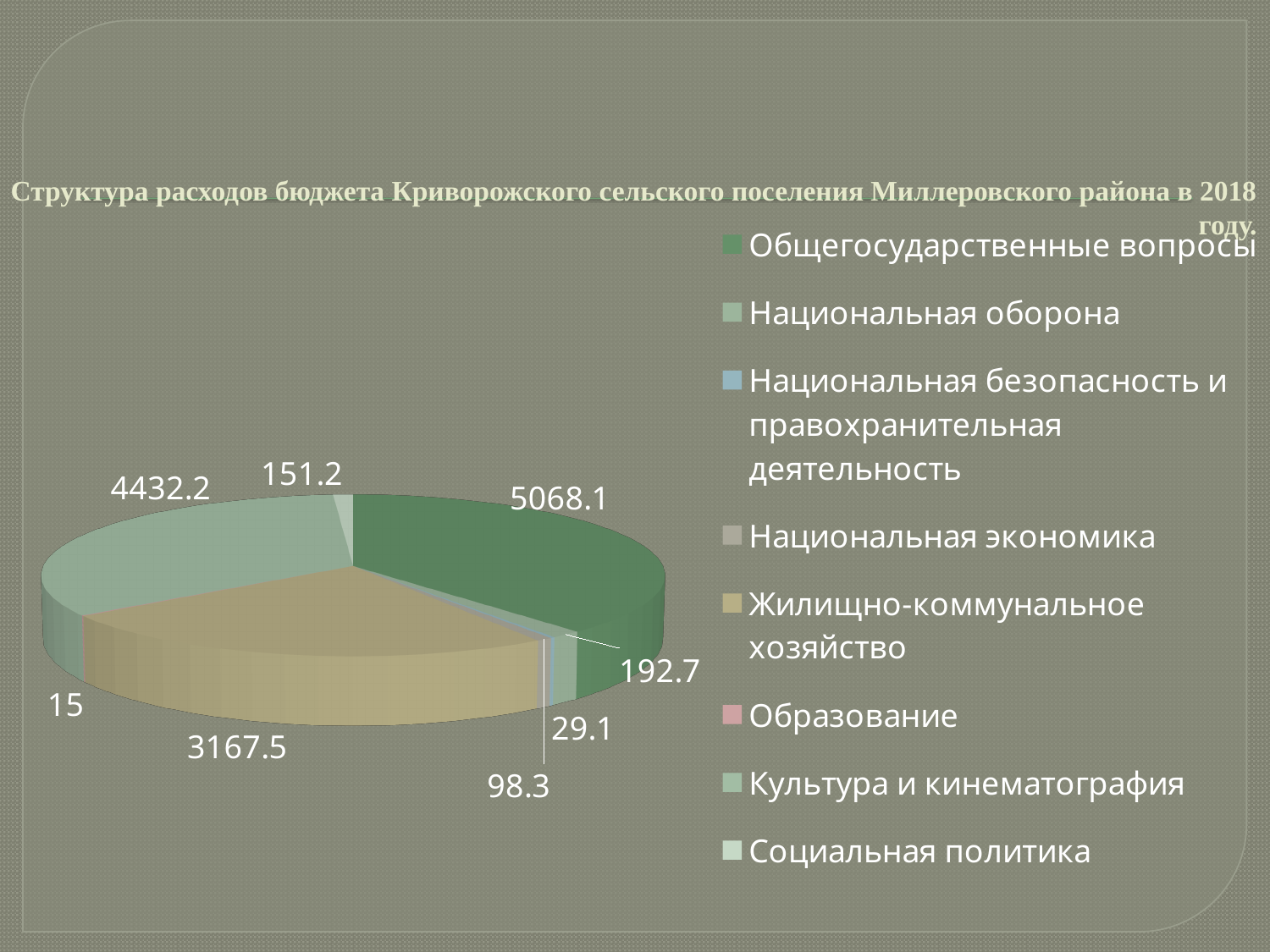
What is the value for Общегосударственные вопросы? 5068.1 How many slices does the pie chart have? 8 Which category has the smallest slice of the pie? Образование What type of chart is shown on the slide? Pie chart Which is larger, the value for Социальная политика or the value for Национальная экономика? Социальная политика What is the value for Образование? 15 Which category has the largest slice of the pie? Общегосударственные вопросы How many entries does the legend list? 8 What is the difference between the values for Общегосударственные вопросы and Культура и кинематография? 635.9 What is the value for Жилищно-коммунальное хозяйство? 3167.5 What is the value for Национальная оборона? 192.7 What is the value for Культура и кинематография? 4432.2